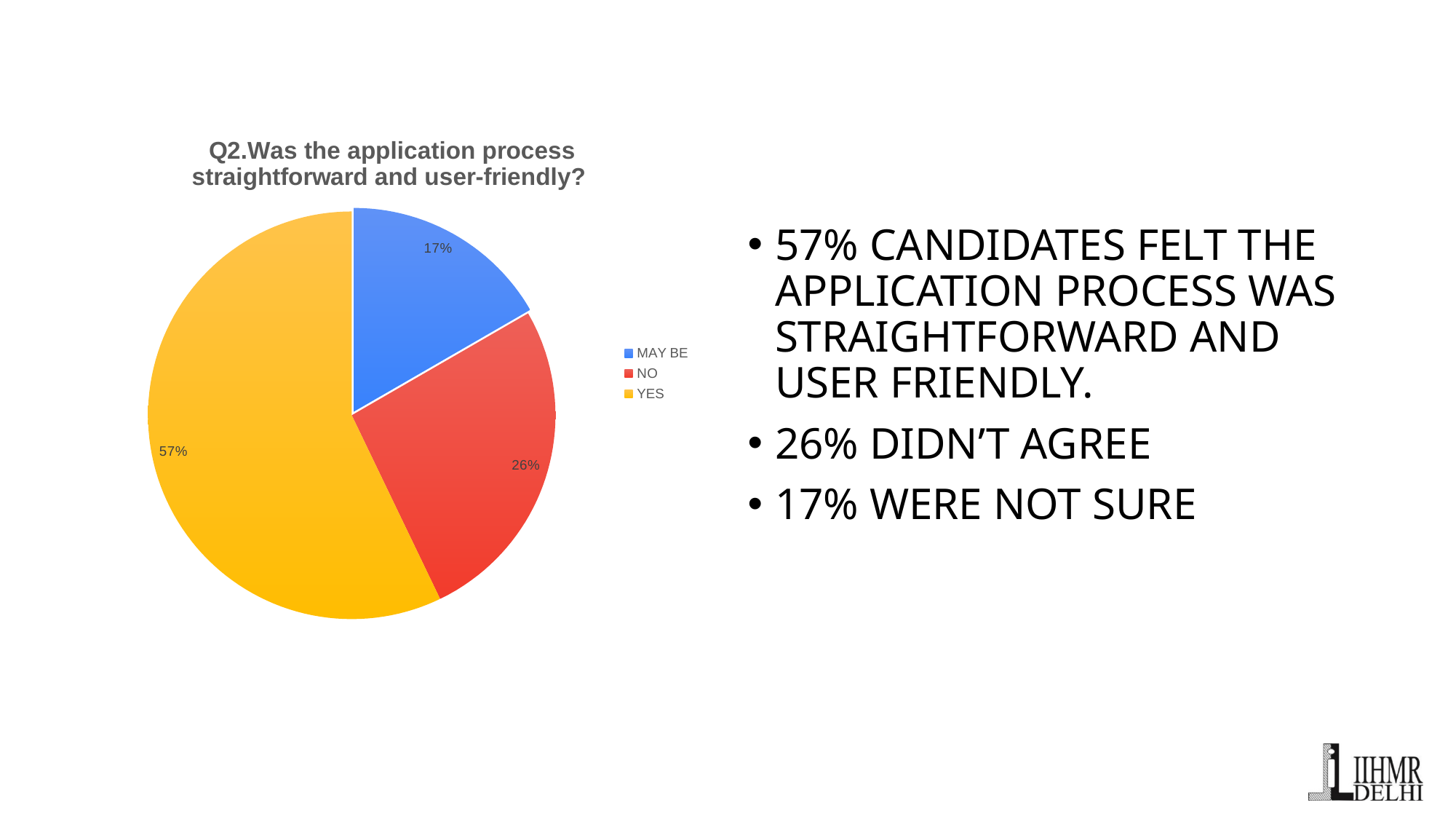
Which slice is larger, NO or MAY BE? NO What is the difference in percentage points between the NO slice and the MAY BE slice? 9 Which category has the largest slice of the pie? YES What type of chart is shown on the slide? Pie chart Which category has the smallest slice of the pie? MAY BE What percentage of the pie is labelled MAY BE? 17% What percentage of the pie is labelled YES? 57% What is the title of the pie chart? Q2.Was the application process straightforward and user-friendly? What is the difference in percentage points between the YES slice and the NO slice? 31 What percentage of the pie is labelled NO? 26% What colour is the YES slice in the pie chart? Yellow How many categories does the pie chart have? 3